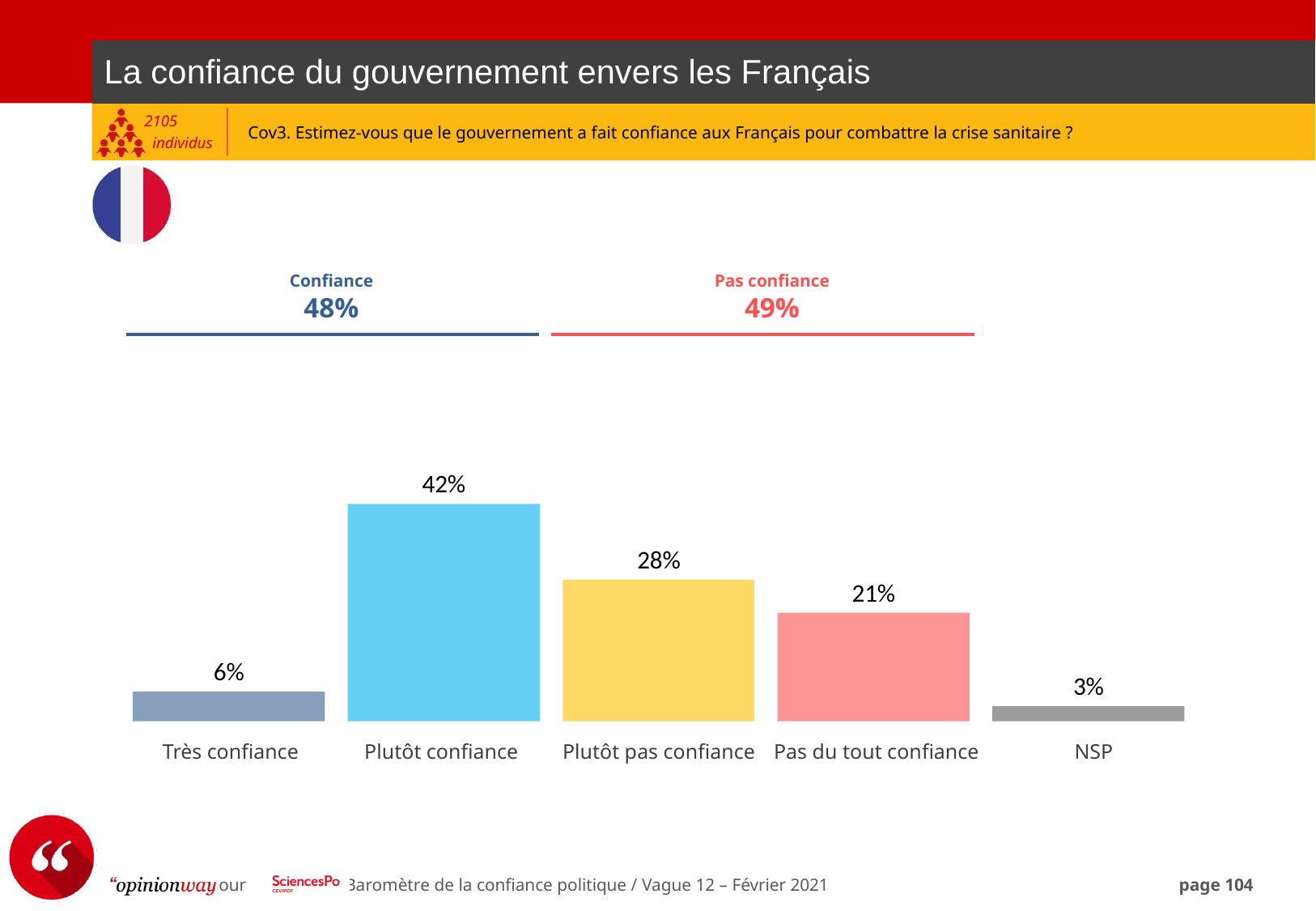
Which category has the highest value? Plutôt confiance How many categories are shown on the x axis? 5 What is the combined 'Confiance' percentage shown above the chart? 48% What is the combined 'Pas confiance' percentage shown above the chart? 49% Which category has the lowest value? NSP What is the value for Très confiance? 6% What is the value for NSP? 3% What is the difference between Plutôt confiance and Plutôt pas confiance? 14% What is the value for Plutôt confiance? 42% Which is larger, Plutôt pas confiance or Pas du tout confiance? Plutôt pas confiance What is the value for Pas du tout confiance? 21% What kind of chart is shown on the slide? Bar chart